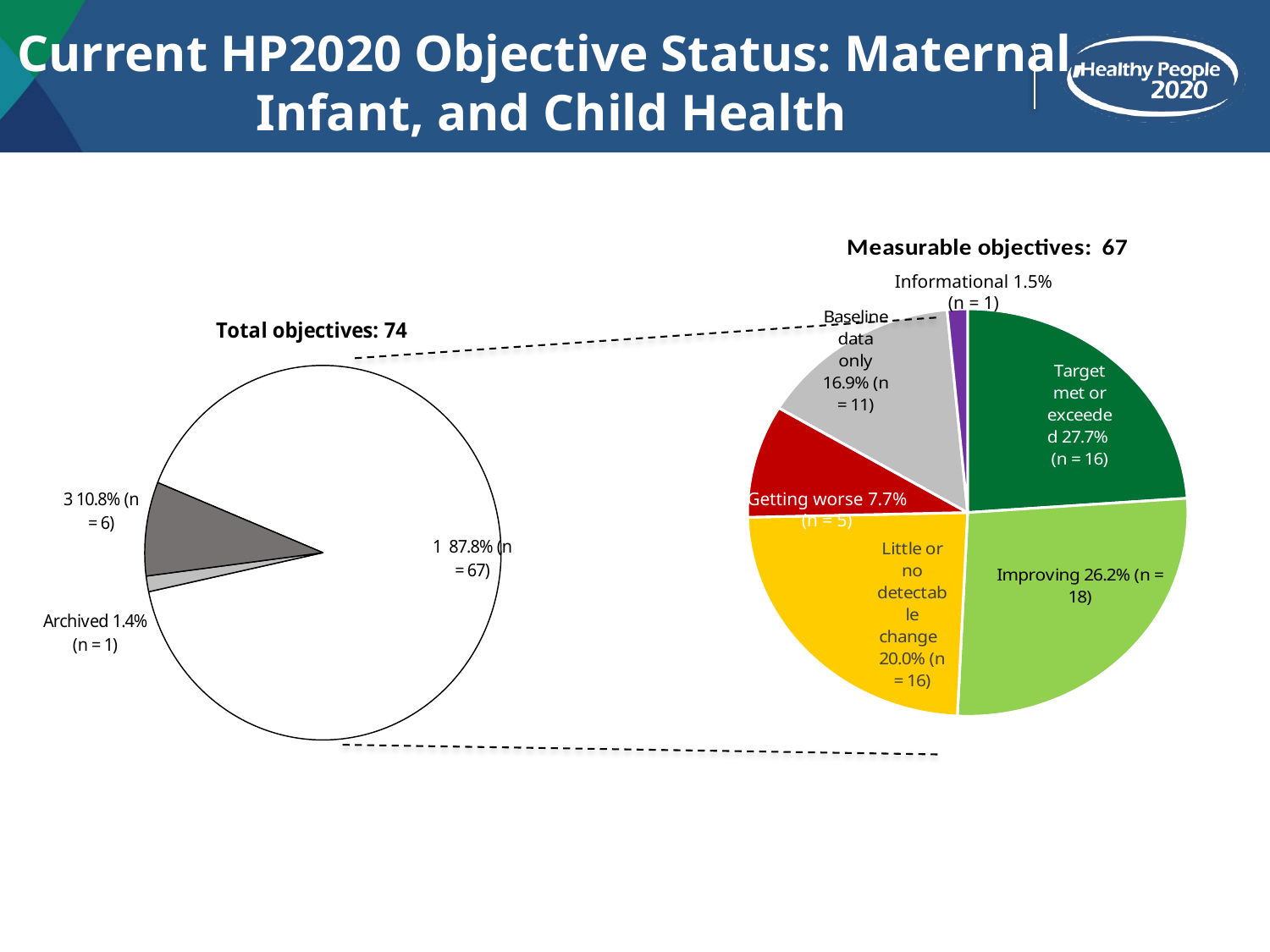
In the Total objectives pie chart, how many objectives (n) are in the largest slice labelled 87.8%? 67 In the Measurable objectives pie chart, how many objectives (n) are Getting worse? 5 In the Measurable objectives pie chart, which category has the largest share? Target met or exceeded In the Measurable objectives pie chart, which is larger: Little or no detectable change or Baseline data only? Little or no detectable change In the Total objectives pie chart, what percentage of objectives are Archived? 1.4% How many slices does the Measurable objectives pie chart have? 6 What kind of chart is used to show the Total objectives on the left of the slide? Pie chart What is the title of the pie chart on the right of the slide? Measurable objectives: 67 In the Measurable objectives pie chart, which category has the smallest share? Informational In the Measurable objectives pie chart, what percentage of objectives are Improving? 26.2% In the Measurable objectives pie chart, what is the difference in percentage points between Target met or exceeded and Getting worse? 20.0 percentage points In the Measurable objectives pie chart, what percentage is labelled Baseline data only? 16.9%